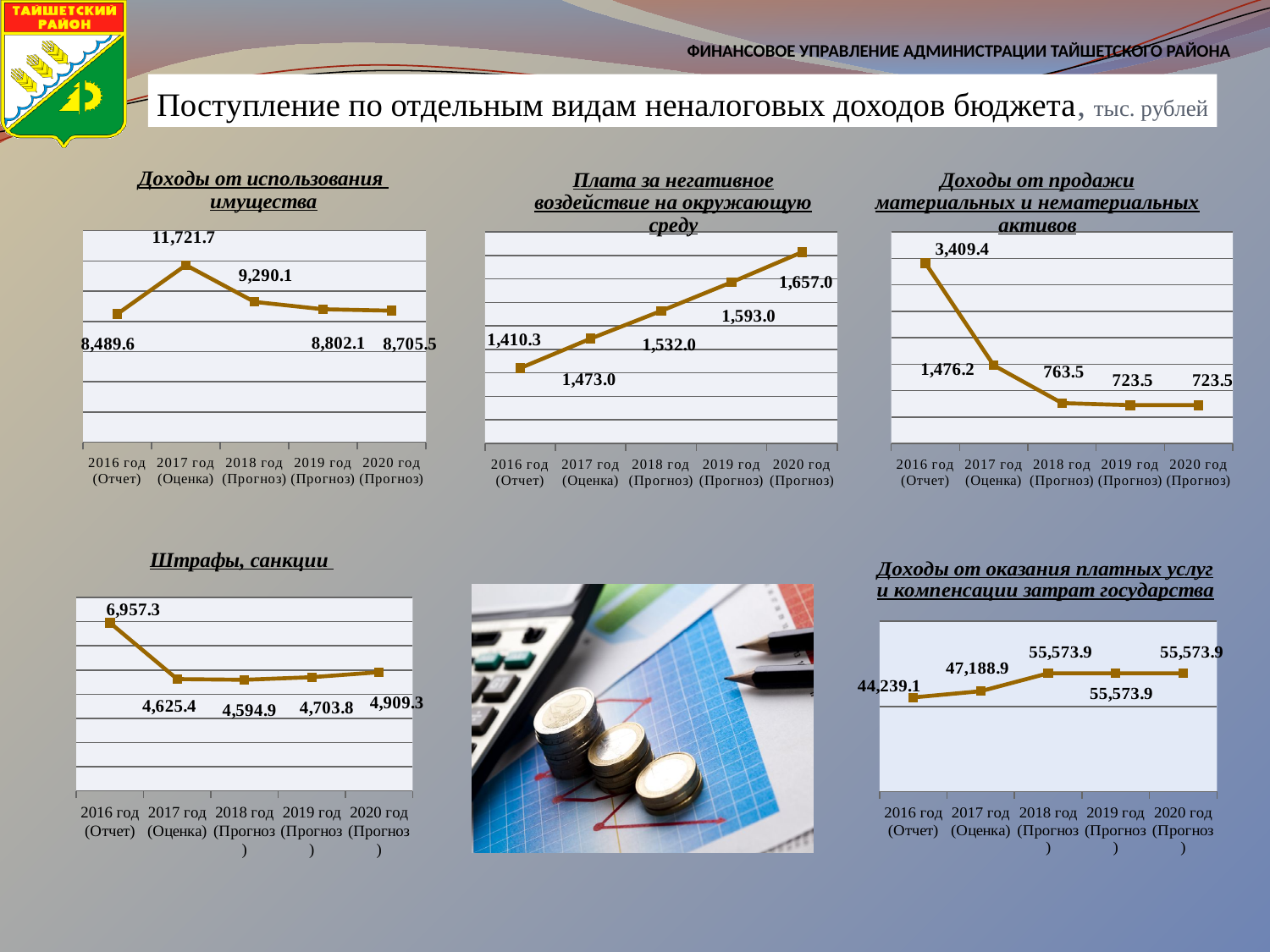
On the chart 'Доходы от продажи материальных и нематериальных активов', what is the value for 2016 год (Отчет)? 3,409.4 On the chart 'Штрафы, санкции', which year has the lowest value? 2018 год (Прогноз) On the chart 'Доходы от использования имущества', which year has the highest value? 2017 год (Оценка) On the chart 'Доходы от оказания платных услуг и компенсации затрат государства', what is the value for 2016 год (Отчет)? 44,239.1 On the chart 'Плата за негативное воздействие на окружающую среду', what is the difference between the 2020 and 2016 values? 246.7 On the chart 'Плата за негативное воздействие на окружающую среду', what is the value for 2020 год (Прогноз)? 1,657.0 How many years are plotted on the chart 'Штрафы, санкции'? 5 On the chart 'Доходы от продажи материальных и нематериальных активов', which year has the highest value? 2016 год (Отчет) On the chart 'Плата за негативное воздействие на окружающую среду', do the values rise or fall from 2016 to 2020? rise On the chart 'Доходы от использования имущества', what is the value for 2017 год (Оценка)? 11,721.7 On the chart 'Доходы от оказания платных услуг и компенсации затрат государства', which is larger: the value for 2017 or the value for 2018? 2018 On the chart 'Штрафы, санкции', what is the difference between the 2016 and 2017 values? 2,331.9